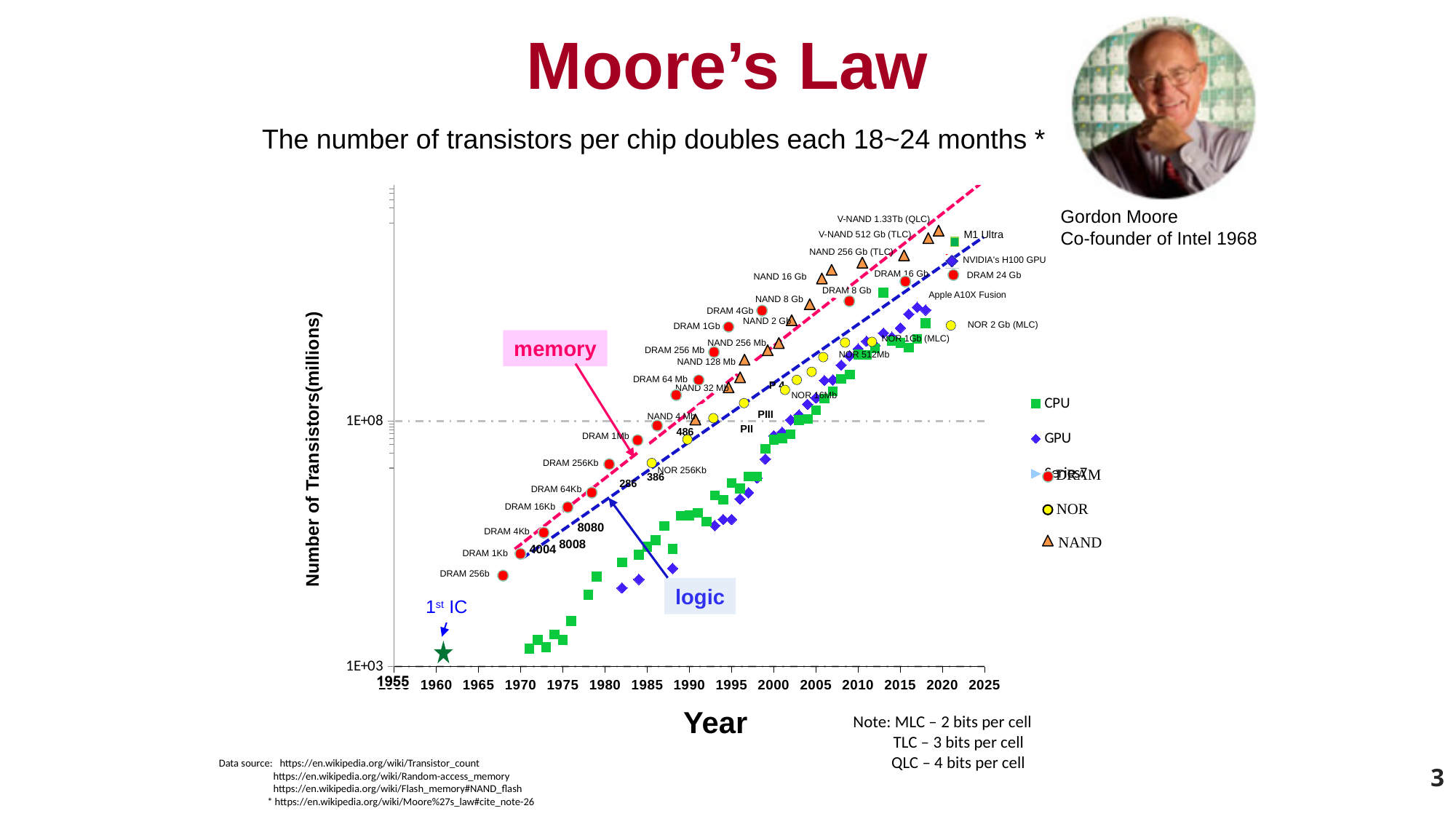
Is the value for NOR 2 Gb (MLC) greater or less than 1E+08? greater What is the label of the y axis? Number of Transistors(millions) Is the value for V-NAND 1.33Tb (QLC) greater or less than 1E+08? greater Is the value for DRAM 1Kb greater or less than 1E+08? less Which labeled point has the highest number of transistors? V-NAND 1.33Tb (QLC) What is the label of the x axis? Year Do the number of transistors rise or fall as the year increases? rise What kind of chart is shown on the slide? scatter chart Which has more transistors, DRAM 1Kb or DRAM 256b? DRAM 1Kb Which has more transistors, DRAM 16 Gb or DRAM 64 Mb? DRAM 16 Gb Which labeled point has the lowest number of transistors? 1st IC